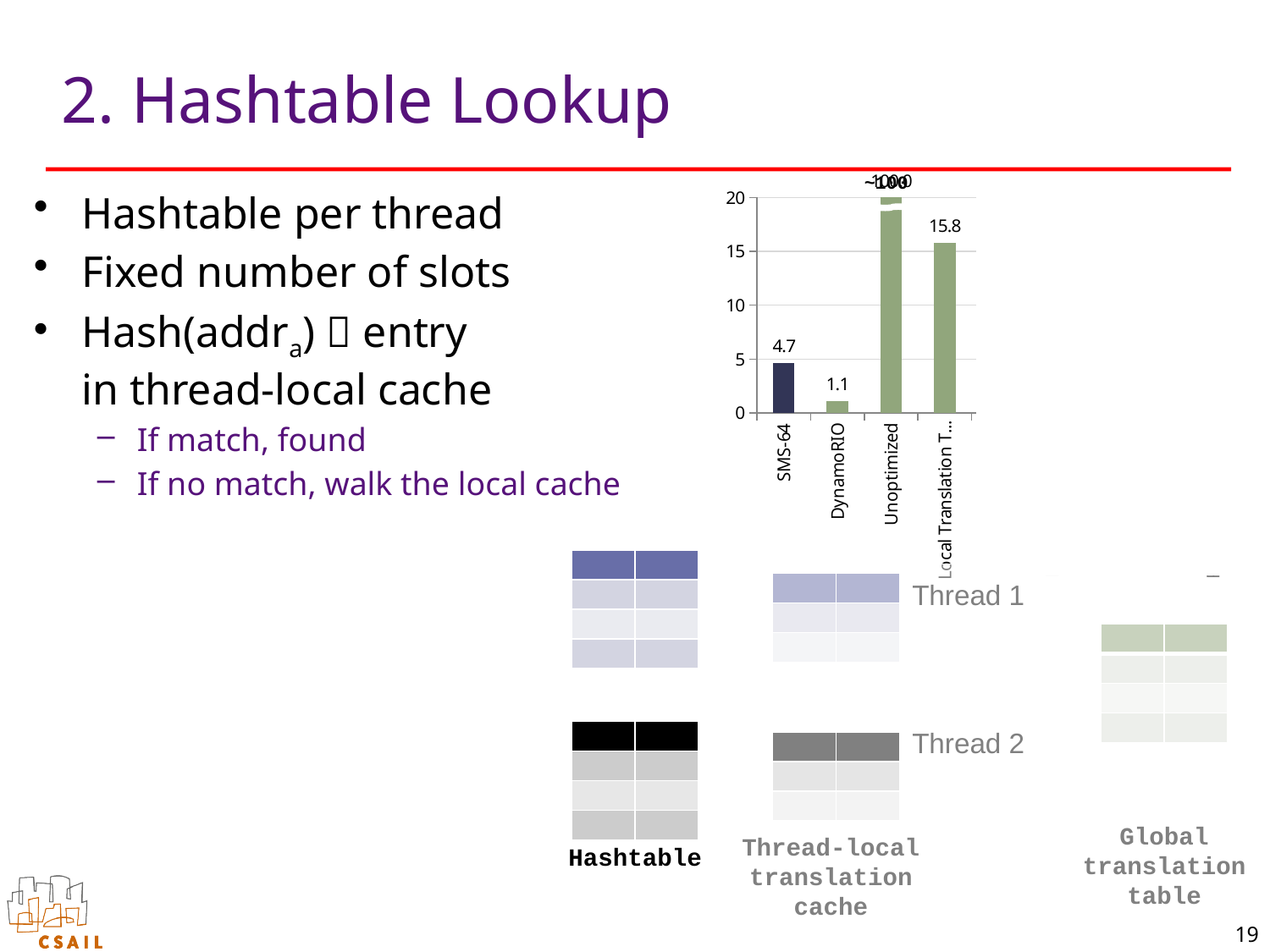
Which category has the highest bar in the chart? Unoptimized What is the difference between the rightmost bar's value (15.8) and the SMS-64 value? 11.1 Is the value of the rightmost bar greater or less than 10? greater What value is labelled on the fourth (rightmost) bar of the chart? 15.8 How many categories are plotted in the bar chart? 4 What value is shown for DynamoRIO in the bar chart? 1.1 What is the highest tick value shown on the chart's vertical axis? 20 Which is larger, the value for SMS-64 or the value for DynamoRIO? SMS-64 Which category has the lowest value in the bar chart? DynamoRIO What is the difference between the SMS-64 value and the DynamoRIO value? 3.6 What kind of chart is shown on the slide? bar chart What value is shown for SMS-64 in the bar chart? 4.7